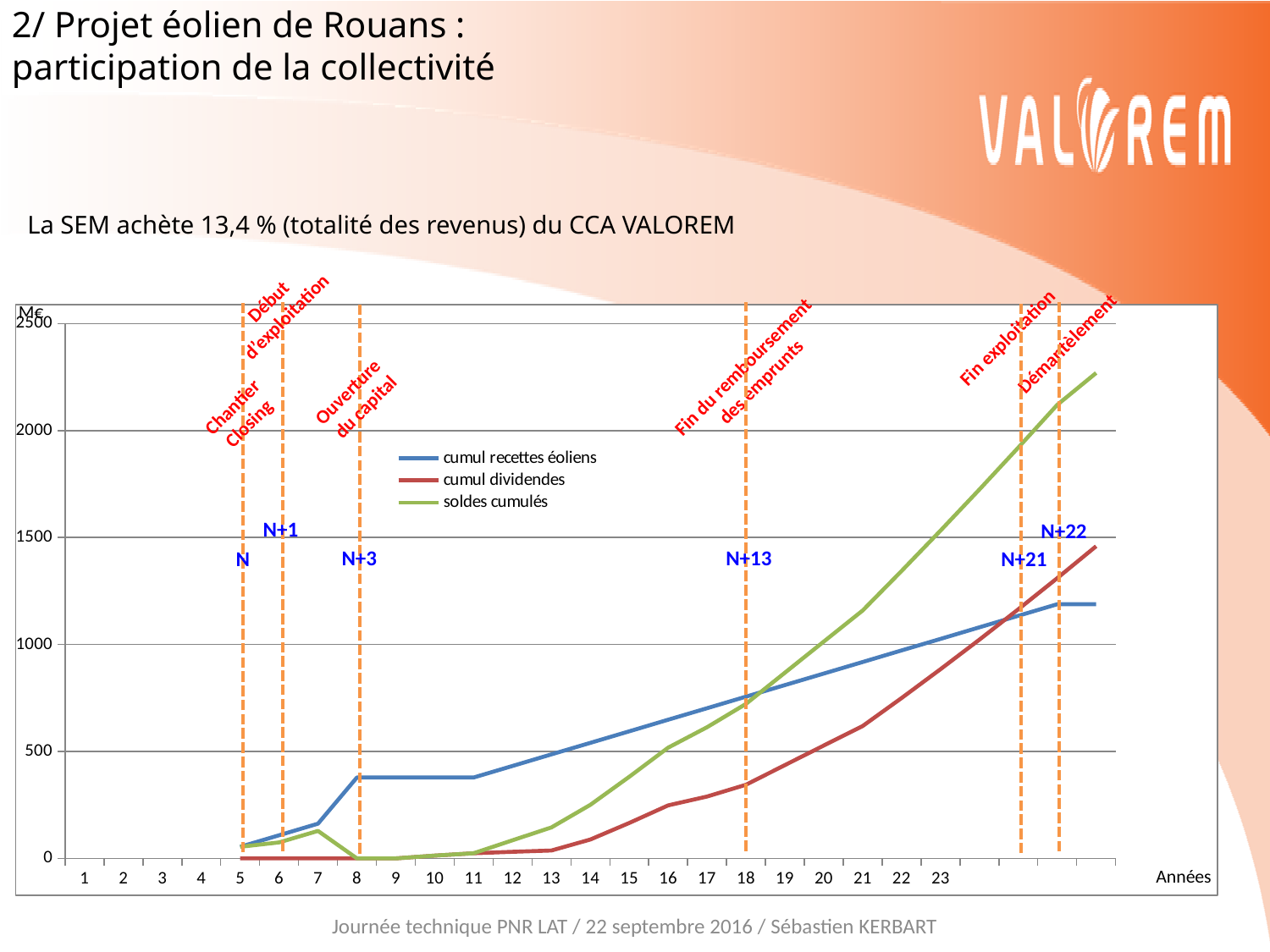
At year 18, is the value for soldes cumulés greater or less than 1000? less At year 11, is the value for cumul recettes éoliens greater or less than 500? less At year 18, is the value for cumul dividendes greater or less than 500? less Which series reaches the highest value at the right end of the chart? soldes cumulés How many series does the chart legend list? 3 Does the cumul recettes éoliens series generally rise or fall along the x axis? rise At year 21, which is higher: soldes cumulés or cumul recettes éoliens? soldes cumulés Which series has the highest value at year 16? cumul recettes éoliens Which series are listed in the chart legend? cumul recettes éoliens, cumul dividendes, soldes cumulés At year 13, which is higher: cumul recettes éoliens or cumul dividendes? cumul recettes éoliens What kind of chart is shown on the slide? line chart